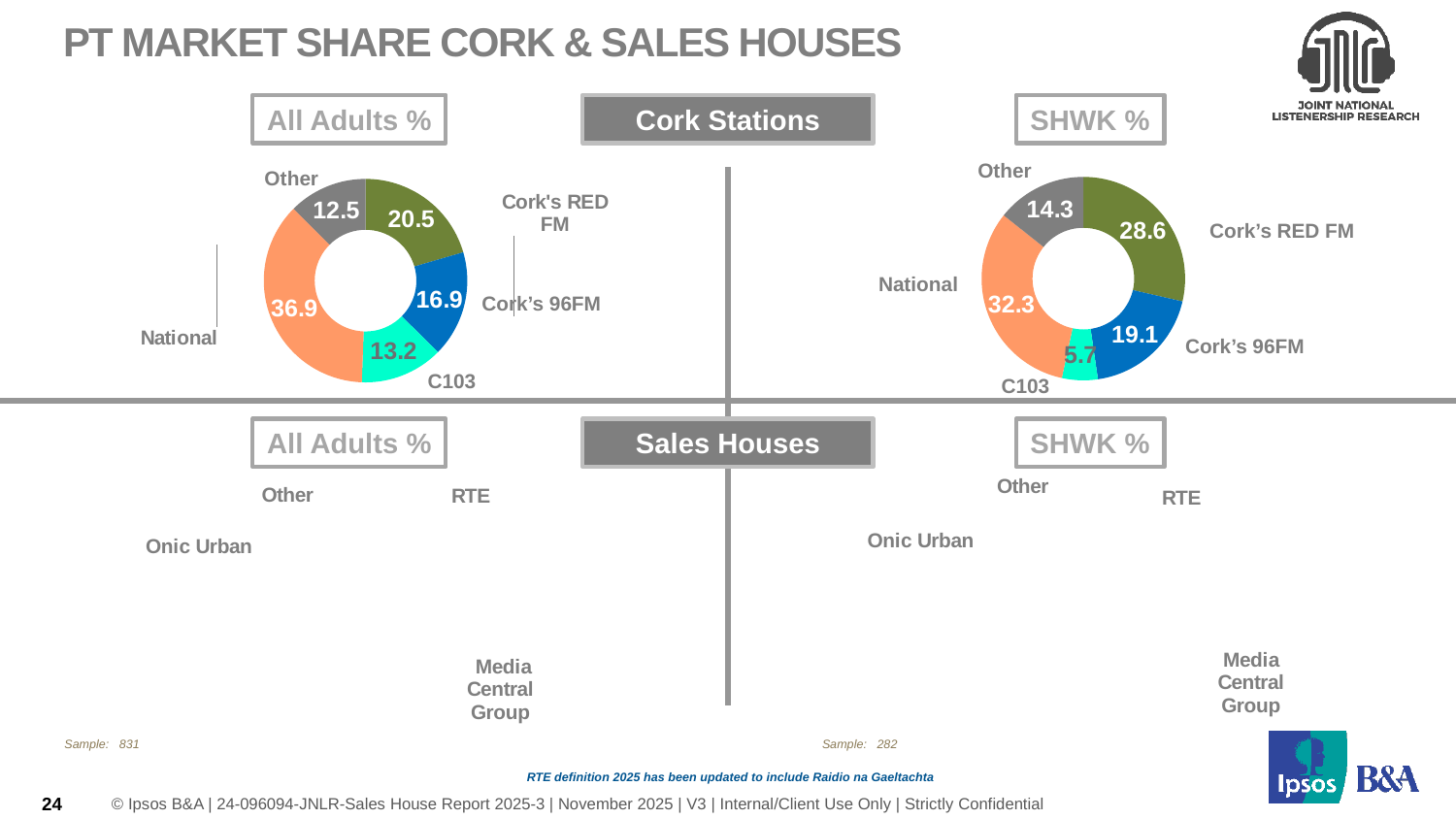
Which is larger in the Cork Stations SHWK % chart: Other or C103? Other In the Cork Stations All Adults % chart, what is the value for Cork's RED FM? 20.5 What is the sample size shown for the SHWK % charts? 282 In the Cork Stations SHWK % chart, which category has the smallest share? C103 What type of chart is used for the Cork Stations All Adults % data? Donut (pie) chart In the Cork Stations SHWK % chart, what is the value for C103? 5.7 In the Cork Stations All Adults % chart, what is the difference between National and Cork's RED FM? 16.4 In the Cork Stations All Adults % chart, which category has the largest share? National How many categories are shown in the Cork Stations All Adults % chart? 5 In the Cork Stations SHWK % chart, what is the value for Cork's 96FM? 19.1 In the Cork Stations SHWK % chart, what is the difference between Cork's RED FM and Cork's 96FM? 9.5 In the Cork Stations All Adults % chart, what is the value for National? 36.9